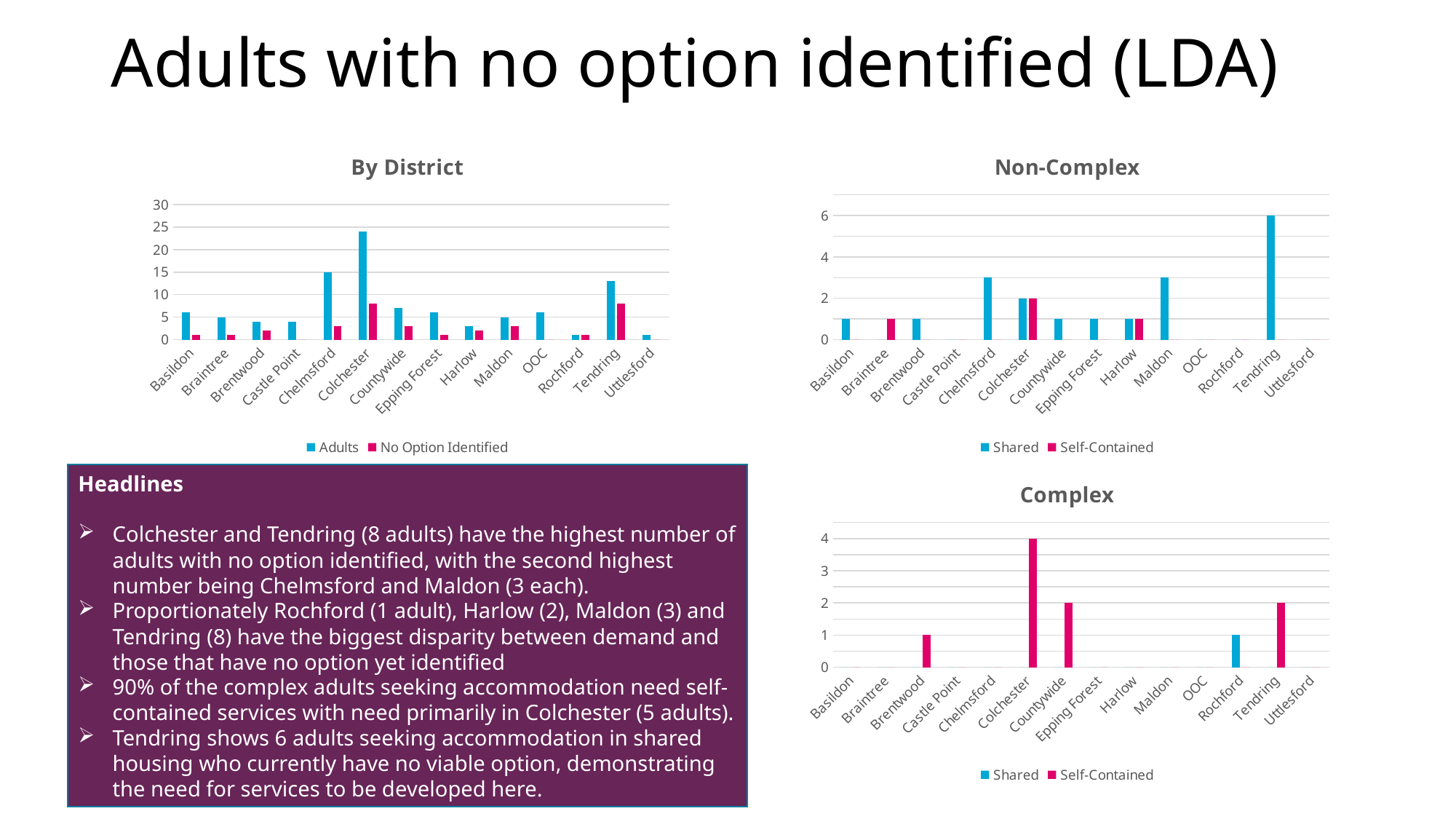
In the Non-Complex chart, what is the Self-Contained value for Colchester? 2 In the By District chart, is the Adults value for Tendring greater or less than 10? greater In the Non-Complex chart, which district has the highest Shared value? Tendring In the By District chart, what is the Adults value for Chelmsford? 15 In the Complex chart, what is the Self-Contained value for Colchester? 4 In the Non-Complex chart, what is the Shared value for Tendring? 6 What kind of chart is the By District chart? bar chart In the Complex chart, what is the difference between the Self-Contained values for Colchester and Countywide? 2 How many series does the legend of the Complex chart list? 2 In the By District chart, which district has the highest Adults value? Colchester In the By District chart, which is larger: the Adults value for Colchester or for Chelmsford? Colchester In the By District chart, is the Adults value for Colchester greater or less than 20? greater